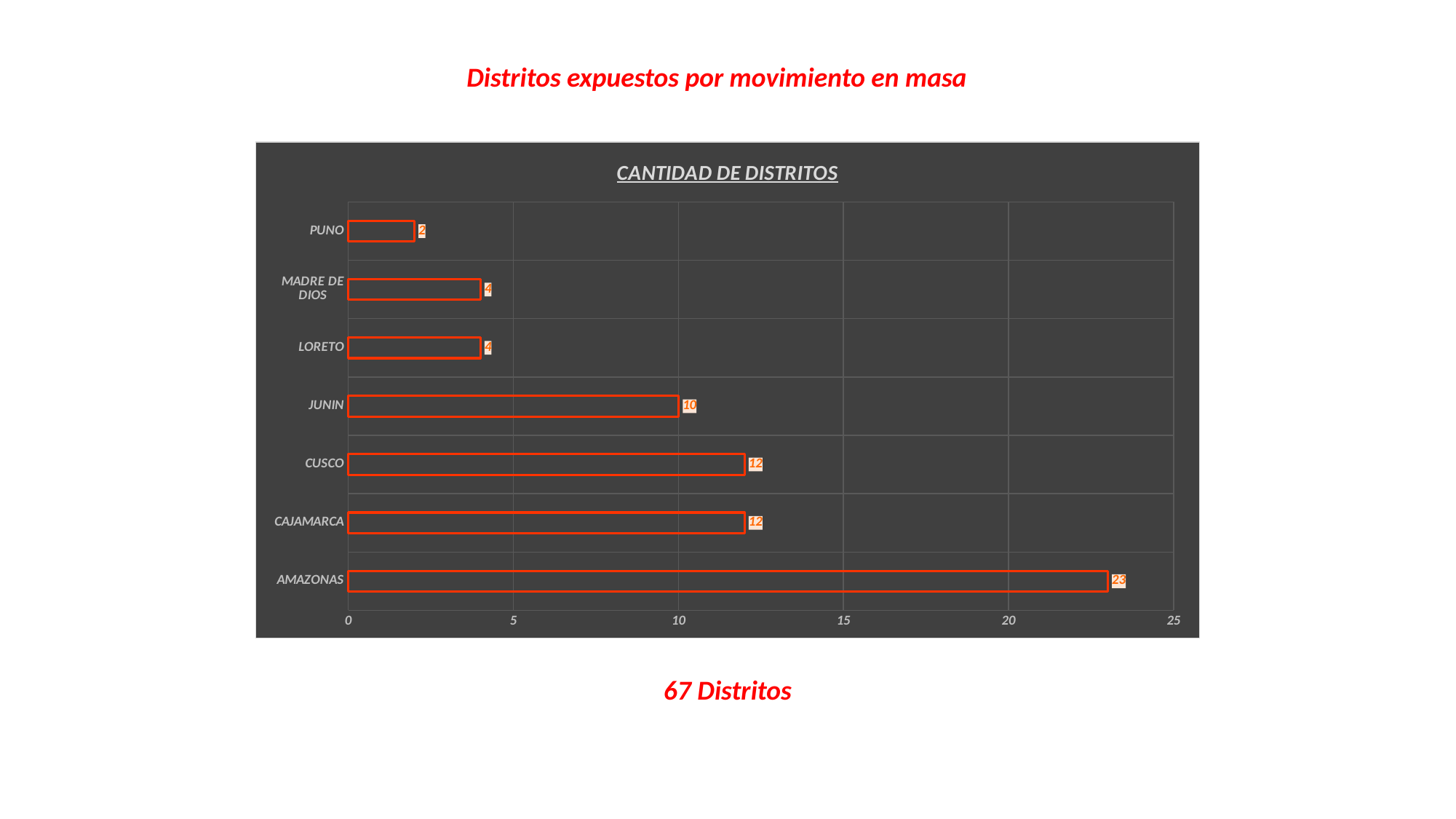
What is the value for AMAZONAS? 23 Which category has the highest value? AMAZONAS What is the value for LORETO? 4 What is the title of the chart? CANTIDAD DE DISTRITOS What is the difference between the values for JUNIN and MADRE DE DIOS? 6 What kind of chart is shown on the slide? Bar chart Which is larger, the value for JUNIN or the value for CAJAMARCA? CAJAMARCA What is the difference between the values for AMAZONAS and CUSCO? 11 What is the value for JUNIN? 10 What is the value for PUNO? 2 How many categories are shown in the chart? 7 Which category has the lowest value? PUNO